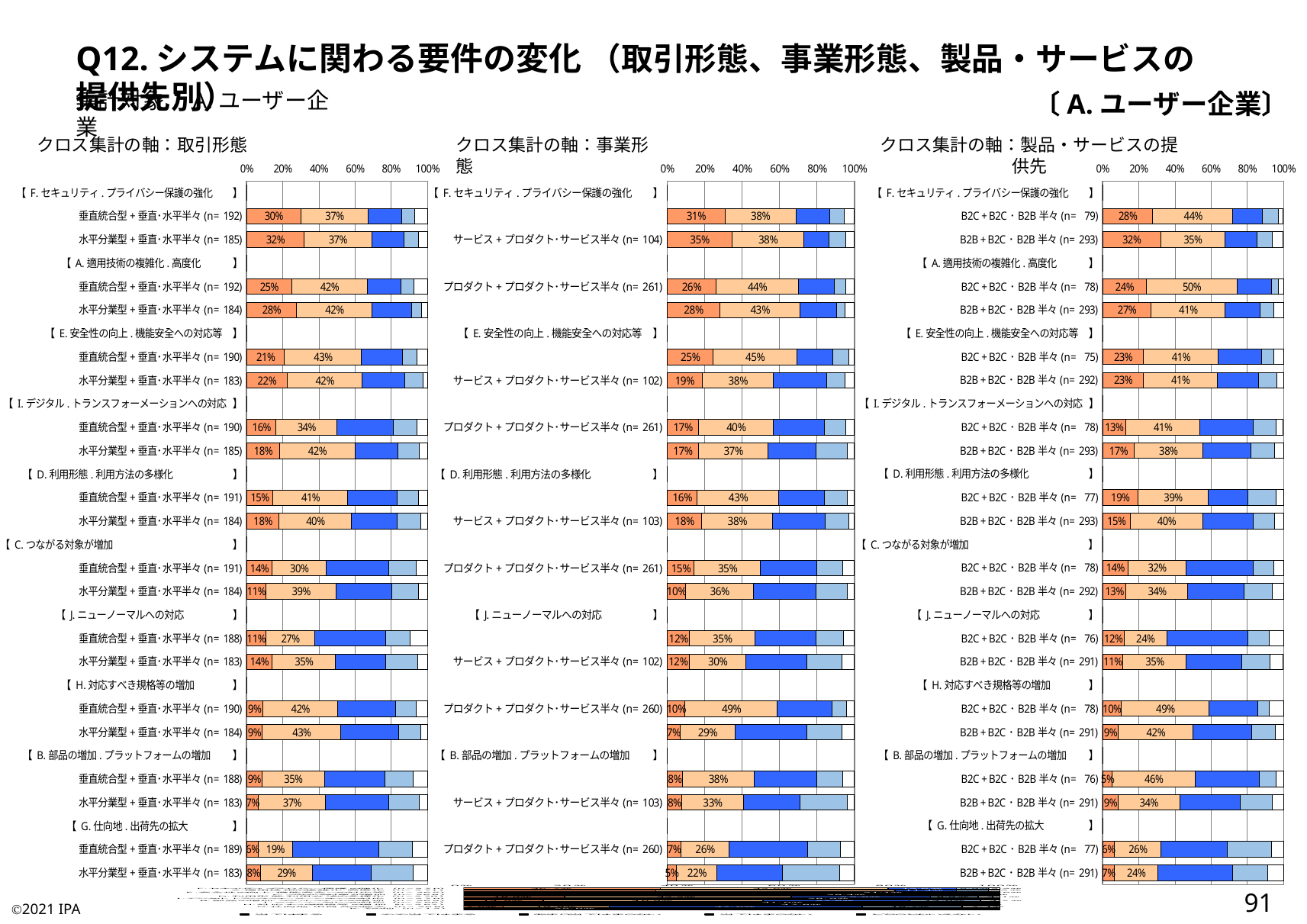
What kind of chart is used on this slide? Stacked horizontal bar chart Which respondent group is indicated in the bracketed label at the top right of the slide? A. ユーザー企業 In the chart titled クロス集計の軸：製品・サービスの提供先, what is the value of the second segment for B2C＋B2C・B2B 半々 (n= 78) under A. 適用技術の複雑化 . 高度化? 50% In the chart titled クロス集計の軸：取引形態, under I. デジタル . トランスフォーメーションへの対応, which row has the larger second-segment value: 垂直統合型＋垂直･水平半々 (n= 190) or 水平分業型＋垂直･水平半々 (n= 185)? 水平分業型＋垂直･水平半々 (n= 185) In the chart titled クロス集計の軸：事業形態, what is the value of the second segment for プロダクト＋プロダクト･サービス半々 (n= 260) under H. 対応すべき規格等の増加? 49% In the chart titled クロス集計の軸：取引形態, what is the value of the first (leftmost) segment for 垂直統合型＋垂直･水平半々 (n= 192) under F. セキュリティ . プライバシー保護の強化? 30% In the chart titled クロス集計の軸：事業形態, what is the value of the first segment for サービス＋プロダクト･サービス半々 (n= 104) under F. セキュリティ . プライバシー保護の強化? 35% In the chart titled クロス集計の軸：製品・サービスの提供先, which row has the largest second-segment value? B2C＋B2C・B2B 半々 (n= 78) under A. 適用技術の複雑化 . 高度化 (50%) In the chart titled クロス集計の軸：取引形態, which row has the smallest first-segment value? 垂直統合型＋垂直･水平半々 (n= 189) under G. 仕向地 . 出荷先の拡大 (6%) In the chart titled クロス集計の軸：取引形態, what is the combined value of the first two segments for 垂直統合型＋垂直･水平半々 (n= 192) under F. セキュリティ . プライバシー保護の強化? 67% How many lettered requirement groups (A–J) are listed in the chart titled クロス集計の軸：事業形態? 10 In the chart titled クロス集計の軸：製品・サービスの提供先, under A. 適用技術の複雑化 . 高度化, how many percentage points larger is the second segment for B2C＋B2C・B2B 半々 (n= 78) than for B2B＋B2C・B2B 半々 (n= 293)? 9 percentage points